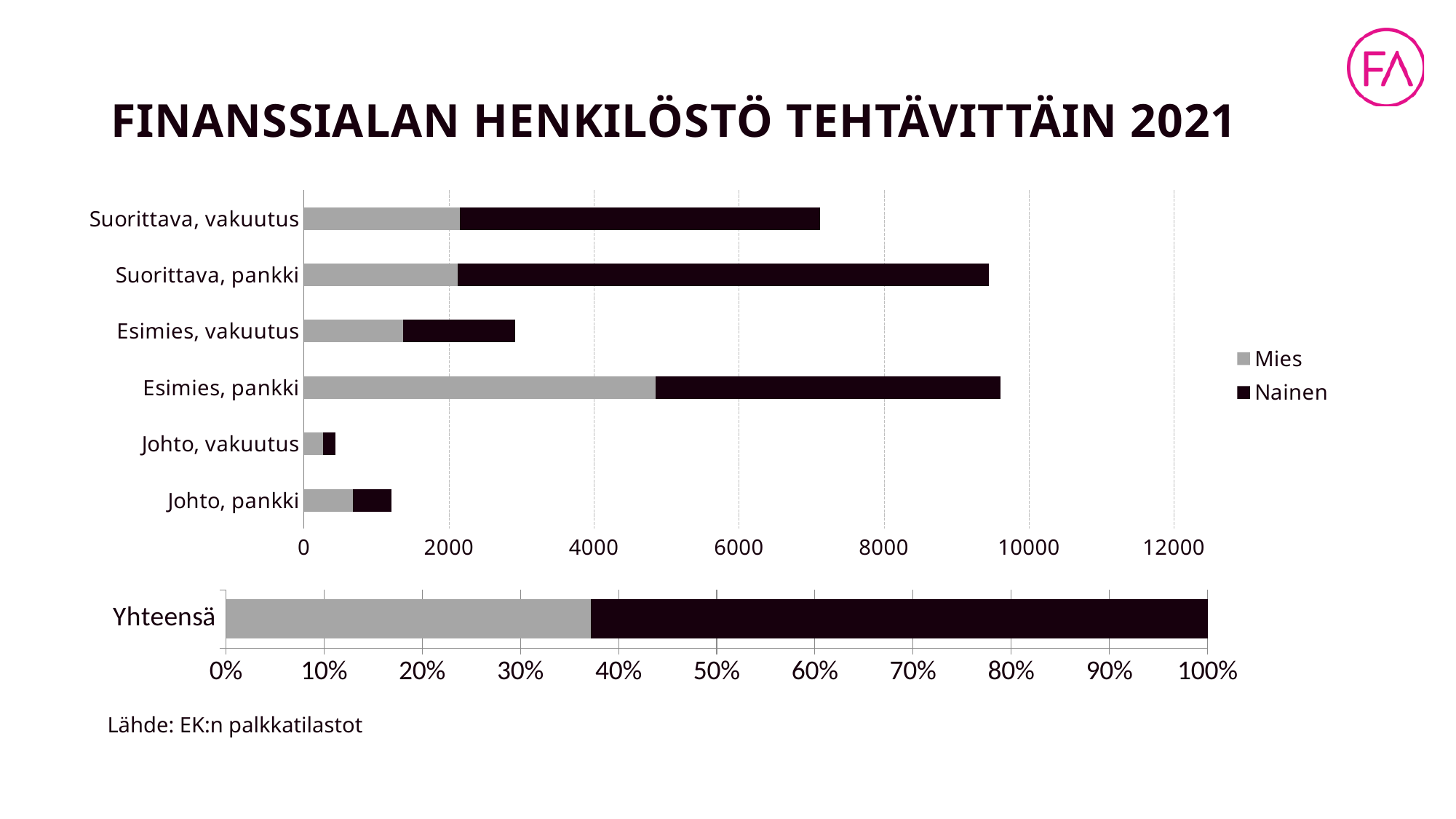
In the top chart, is the total for Esimies, vakuutus greater or less than 4000? less In the bottom Yhteensä chart, is the Mies share greater or less than 40%? less In the top chart, which category has the largest Mies segment? Esimies, pankki What kind of chart is the top chart? Stacked bar chart What source is cited below the charts? Lähde: EK:n palkkatilastot In the top chart, is the total for Johto, pankki greater or less than 2000? less In the bottom Yhteensä chart, which series has the larger share, Mies or Nainen? Nainen In the top chart, how many job categories are shown? 6 In the top chart, which category has the smallest total bar? Johto, vakuutus How many series does the legend list? 2